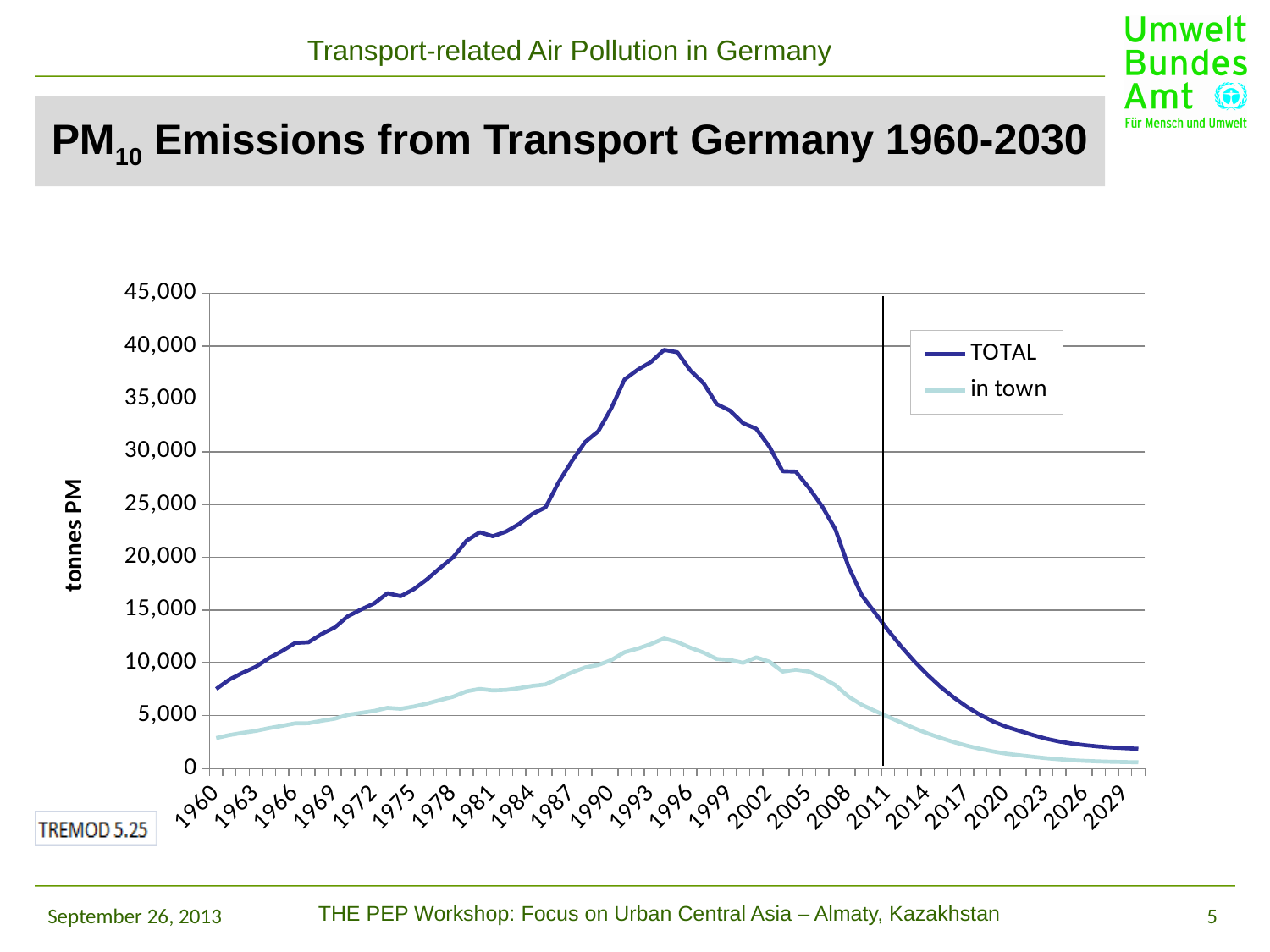
Is the TOTAL value for 1960 greater or less than 5,000? greater In 1993, which series has the larger value, TOTAL or in town? TOTAL Does the TOTAL series rise or fall between 1996 and 2029? fall Is the peak of the TOTAL series greater or less than 35,000? greater How many series does the chart legend list? 2 What is the label on the vertical axis of the chart? tonnes PM What kind of chart is shown on the slide? line chart What are the two series named in the legend? TOTAL and in town Is the TOTAL value for 1990 greater or less than 30,000? greater